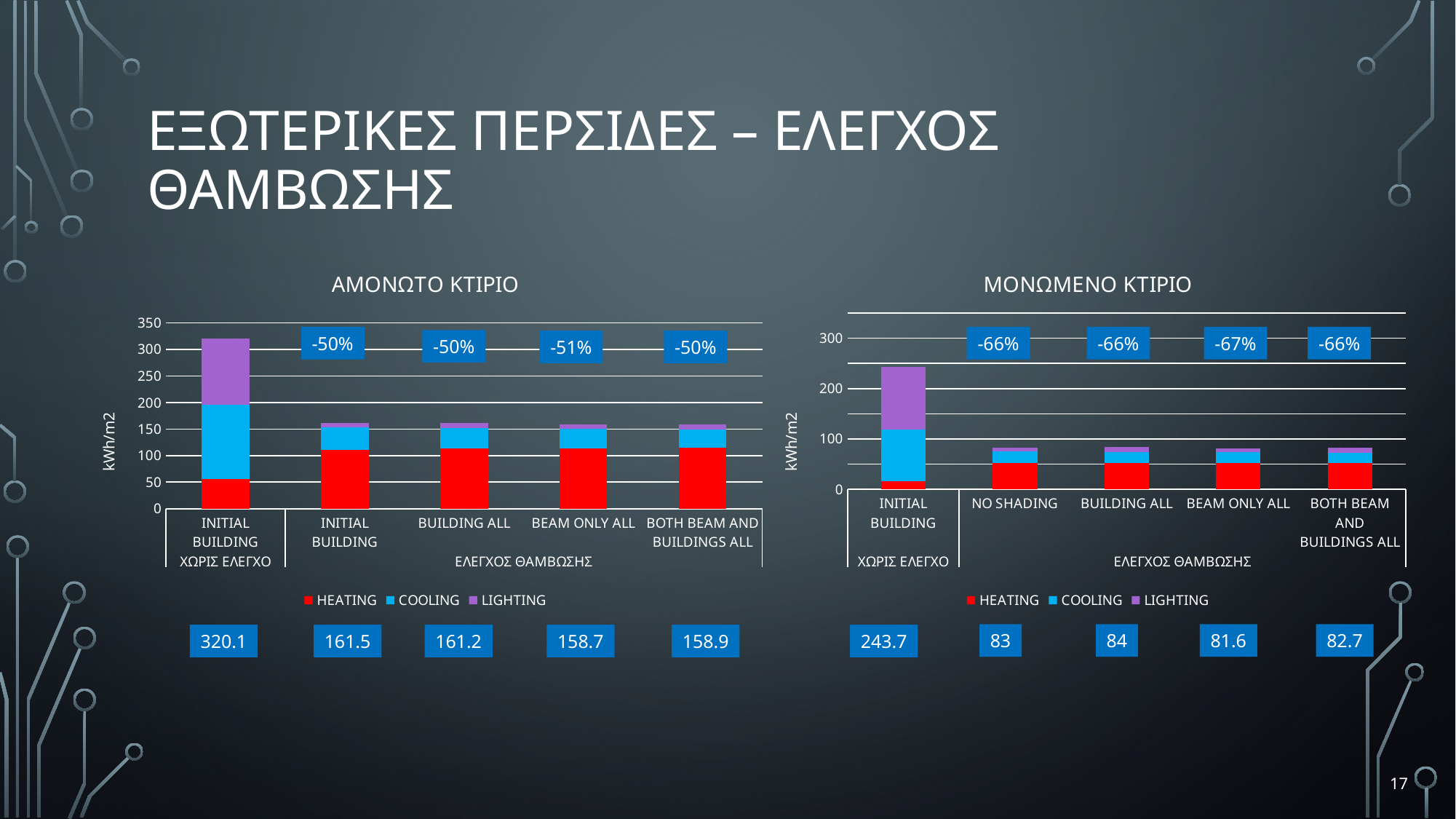
In the ΑΜΟΝΩΤΟ ΚΤΙΡΙΟ chart, what percentage change is shown above the BEAM ONLY ALL bar? -51% How many bars are plotted in the ΑΜΟΝΩΤΟ ΚΤΙΡΙΟ chart? 5 What kind of chart is the ΑΜΟΝΩΤΟ ΚΤΙΡΙΟ chart? Stacked bar chart In the ΑΜΟΝΩΤΟ ΚΤΙΡΙΟ chart, what is the difference between the totals for INITIAL BUILDING ΧΩΡΙΣ ΕΛΕΓΧΟ and INITIAL BUILDING under ΕΛΕΓΧΟΣ ΘΑΜΒΩΣΗΣ? 158.6 In the ΑΜΟΝΩΤΟ ΚΤΙΡΙΟ chart, is the HEATING value for INITIAL BUILDING ΧΩΡΙΣ ΕΛΕΓΧΟ greater or less than 100? less In the ΜΟΝΩΜΕΝΟ ΚΤΙΡΙΟ chart, what is the total value shown for BEAM ONLY ALL? 81.6 In the ΑΜΟΝΩΤΟ ΚΤΙΡΙΟ chart, what is the total value shown for INITIAL BUILDING ΧΩΡΙΣ ΕΛΕΓΧΟ? 320.1 What is the y-axis label on the ΜΟΝΩΜΕΝΟ ΚΤΙΡΙΟ chart? kWh/m2 In the ΜΟΝΩΜΕΝΟ ΚΤΙΡΙΟ chart, what percentage change is shown above the NO SHADING bar? -66% In the ΜΟΝΩΜΕΝΟ ΚΤΙΡΙΟ chart, which bar has the highest total? INITIAL BUILDING ΧΩΡΙΣ ΕΛΕΓΧΟ In the ΜΟΝΩΜΕΝΟ ΚΤΙΡΙΟ chart, what is the difference between the totals for BUILDING ALL and NO SHADING? 1 How many series does the legend of the ΜΟΝΩΜΕΝΟ ΚΤΙΡΙΟ chart list? 3